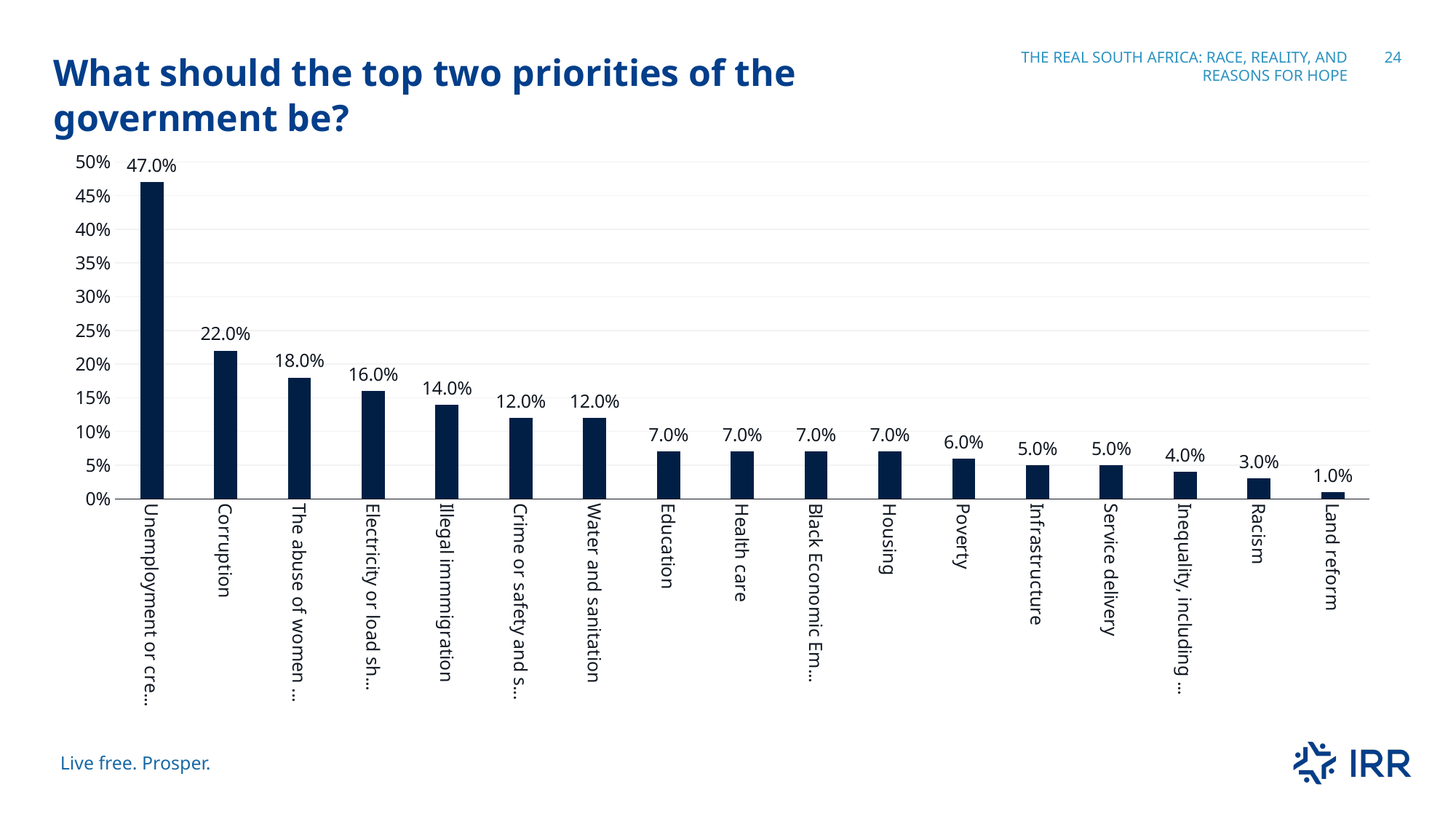
What is the value for Poverty? 6.0% What kind of chart is shown on the slide? Bar chart What is the difference between the values for Corruption and Education? 15.0% What is the value for Water and sanitation? 12.0% How many categories are shown on the chart? 17 Which category has the lowest value? Land reform What is the value for Racism? 3.0% Which is larger, the value for Infrastructure or the value for Inequality, including ...? Infrastructure What is the value for Corruption? 22.0% What is the title of the chart? What should the top two priorities of the government be? What is the value for Illegal immigration? 14.0% Which category has the highest value? Unemployment or cre...